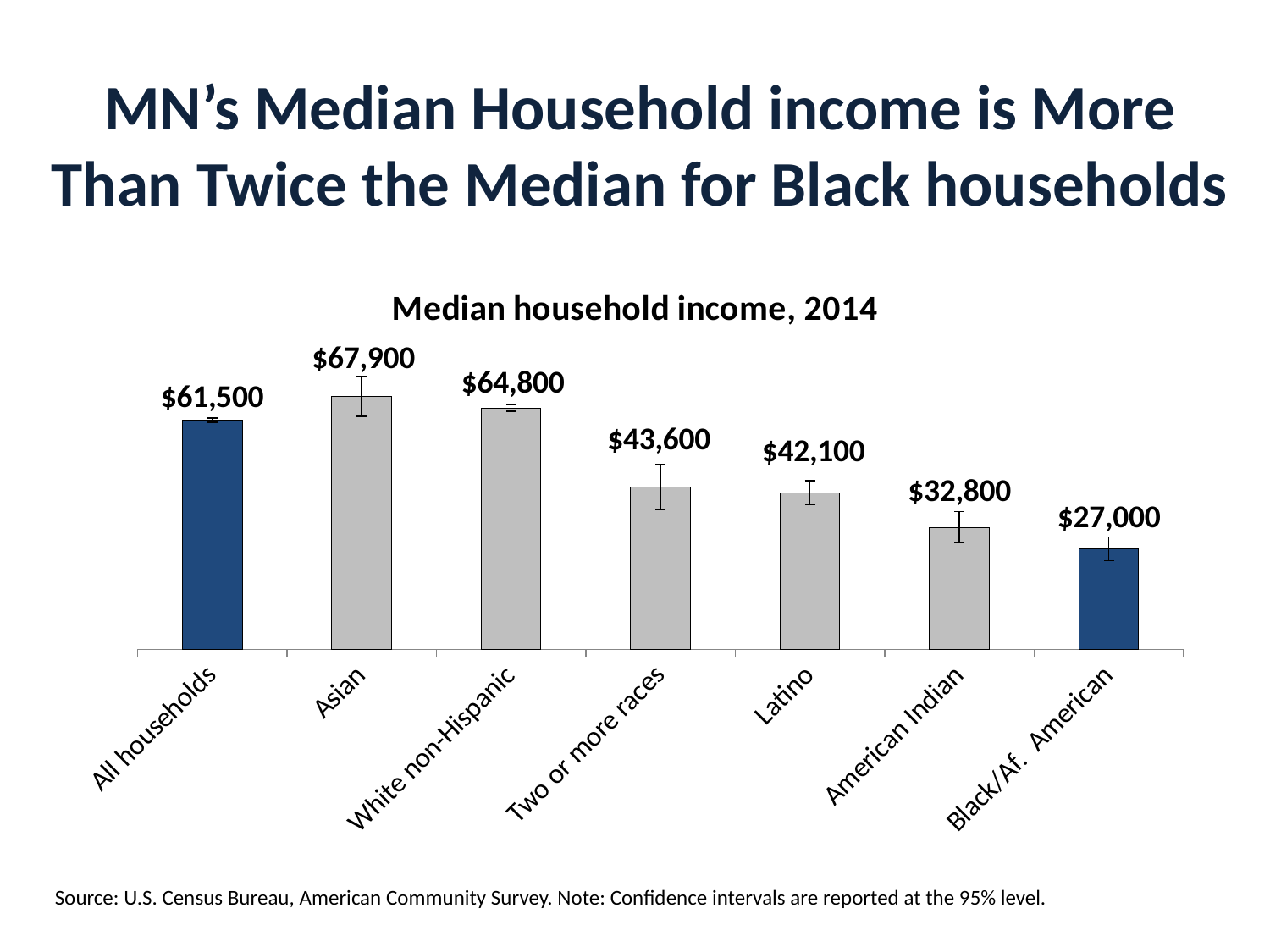
What is the title of the chart? Median household income, 2014 Which category has the highest median household income? Asian What is the median household income for Asian households? $67,900 How many categories are shown in the chart? 7 Which category has the lowest median household income? Black/Af. American Which has a higher median household income, Two or more races or American Indian? Two or more races What is the difference between the median household income for All households and for Black/Af. American households? $34,500 What is the median household income for Latino households? $42,100 What is the difference between the median household income for Asian and White non-Hispanic households? $3,100 What is the median household income for Black/Af. American households? $27,000 What is the median household income for All households? $61,500 What kind of chart is shown on the slide? Bar chart